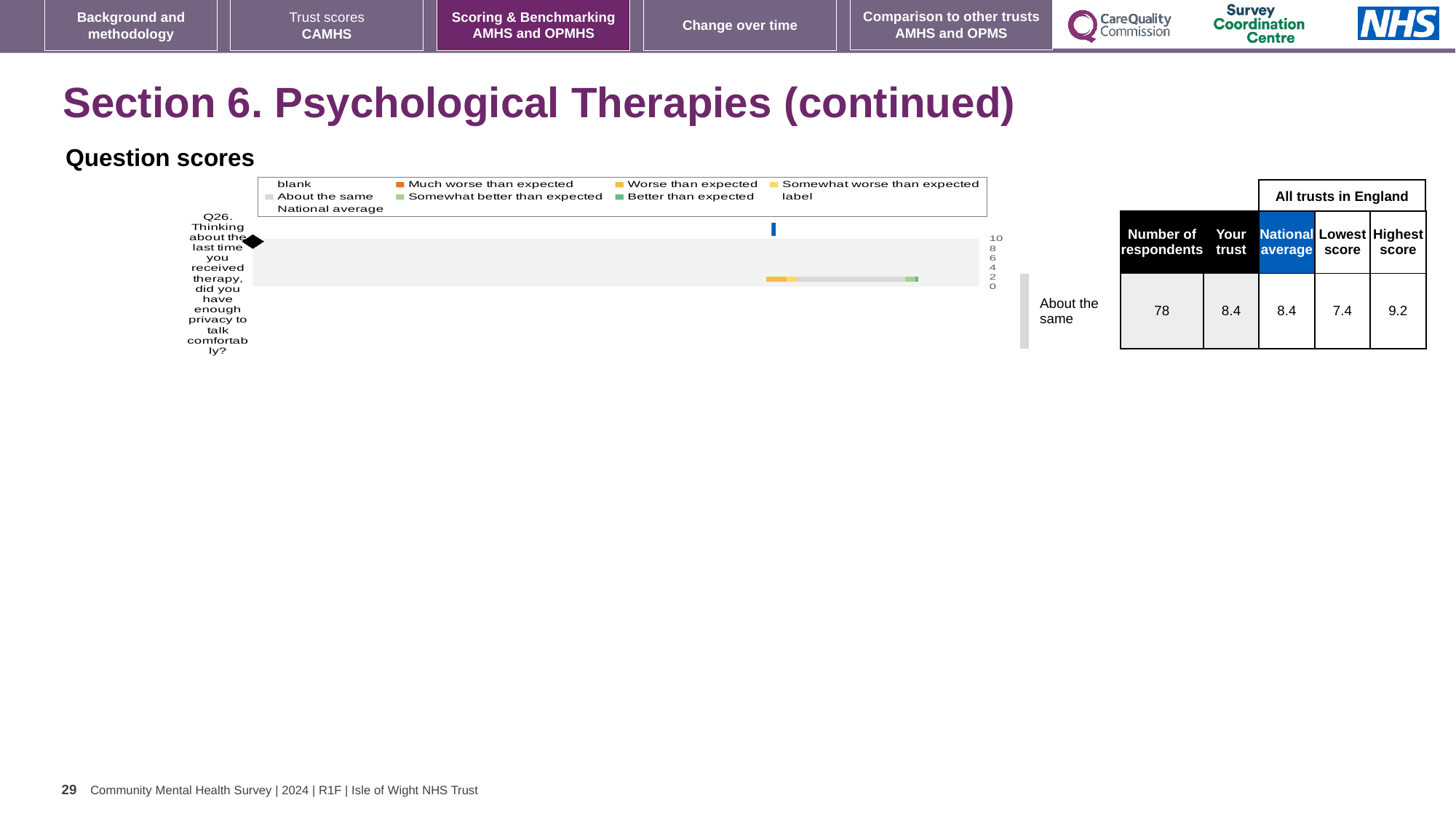
In the table beside the chart, what is the national average score for Q26? 8.4 Is the 'Your trust' score for Q26 higher or lower than the national average? neither, both are 8.4 What type of chart is shown under 'Question scores'? bar chart In the table beside the chart, what is the lowest score among all trusts in England for Q26? 7.4 In the table beside the chart, how many respondents answered Q26? 78 What is the difference between the highest score (9.2) and the lowest score (7.4) for Q26? 1.8 In the table beside the chart, what is the 'Your trust' score for Q26? 8.4 Which question is plotted in the Question scores chart? Q26. Thinking about the last time you received therapy, did you have enough privacy to talk comfortably? What is the maximum value shown on the chart's score axis? 10 What benchmark category is shown for Q26 next to the chart? About the same In the table beside the chart, what is the highest score among all trusts in England for Q26? 9.2 How many survey questions are plotted in the Question scores chart? 1